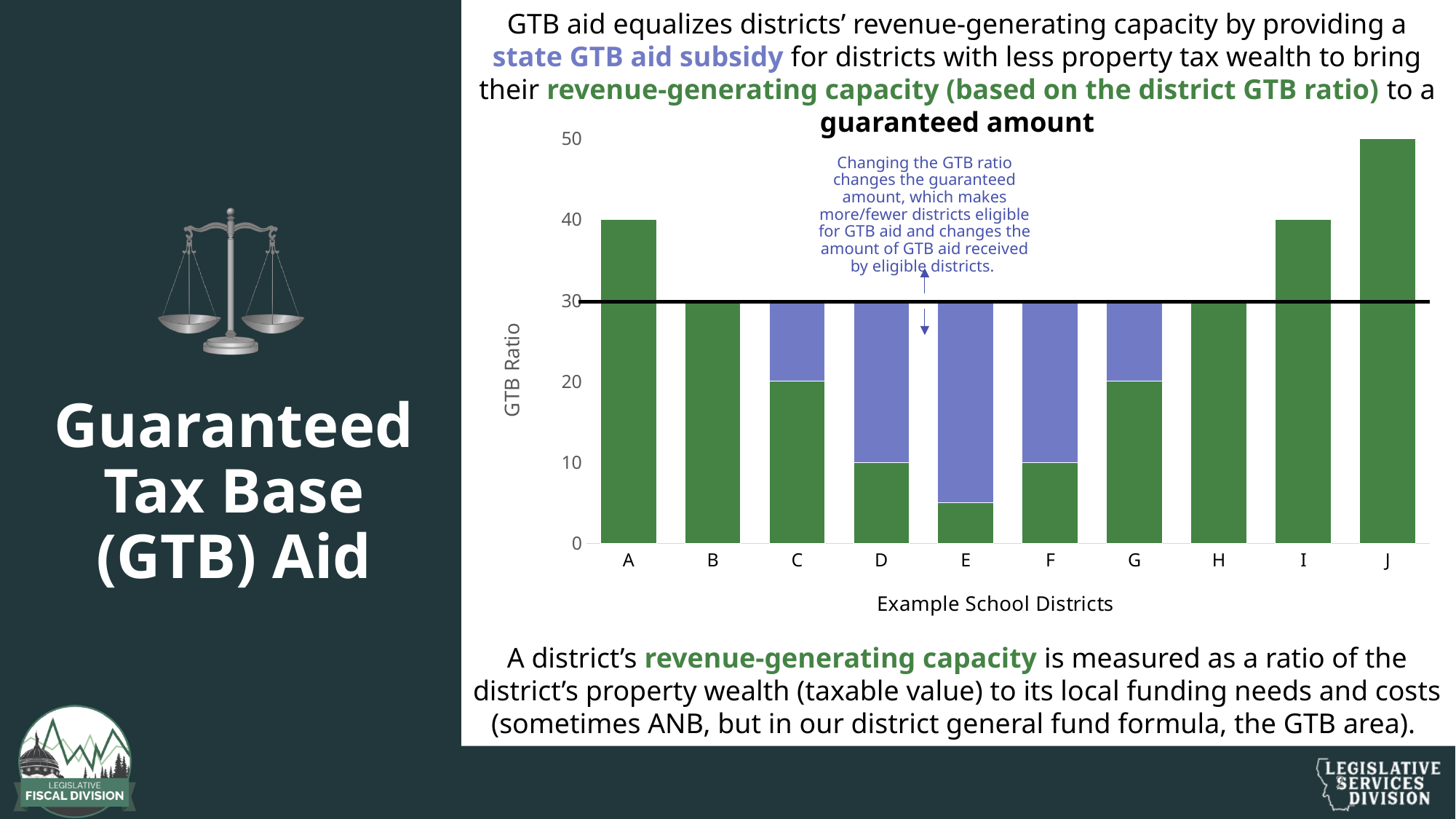
What is the GTB ratio shown for district J? 50 Which example school district has the highest GTB ratio in the chart? J Is the green bar for district E greater or less than 10? less What is the GTB ratio shown for district A? 40 Which example school district has the lowest green bar (own GTB ratio) in the chart? E What is the label of the y axis of the chart? GTB Ratio What is the difference between the GTB ratio of district J and district A? 10 Which has a higher GTB ratio, district A or district B? A How many example school districts are shown on the x axis of the chart? 10 What is the total height of the stacked bar (green plus blue) for district C? 30 What kind of chart is shown on the slide? bar chart What is the height of the green bar for district D? 10